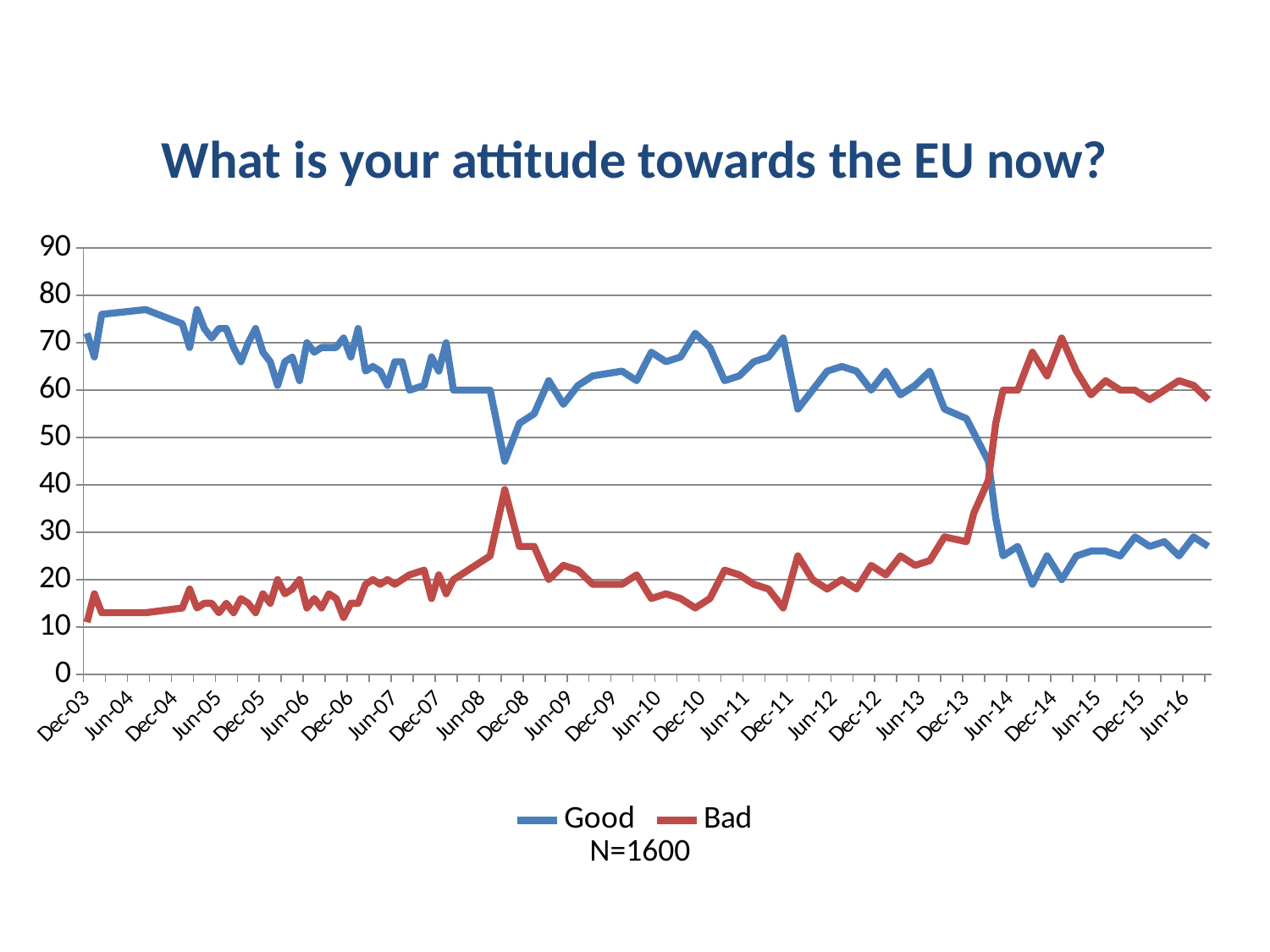
At Jun-16, which series has the larger value, Good or Bad? Bad What kind of chart is shown on the slide? line chart What is the title of the chart? What is your attitude towards the EU now? How many series does the legend list? 2 Is the value for Good at Dec-03 greater or less than 60? greater What colour is the line for the Good series? blue Is the value for Bad at Dec-03 greater or less than 20? less Overall, does the Good series rise or fall from Dec-03 to Jun-16? fall Is the value for Good at Jun-16 greater or less than 40? less At Dec-03, which series has the larger value, Good or Bad? Good